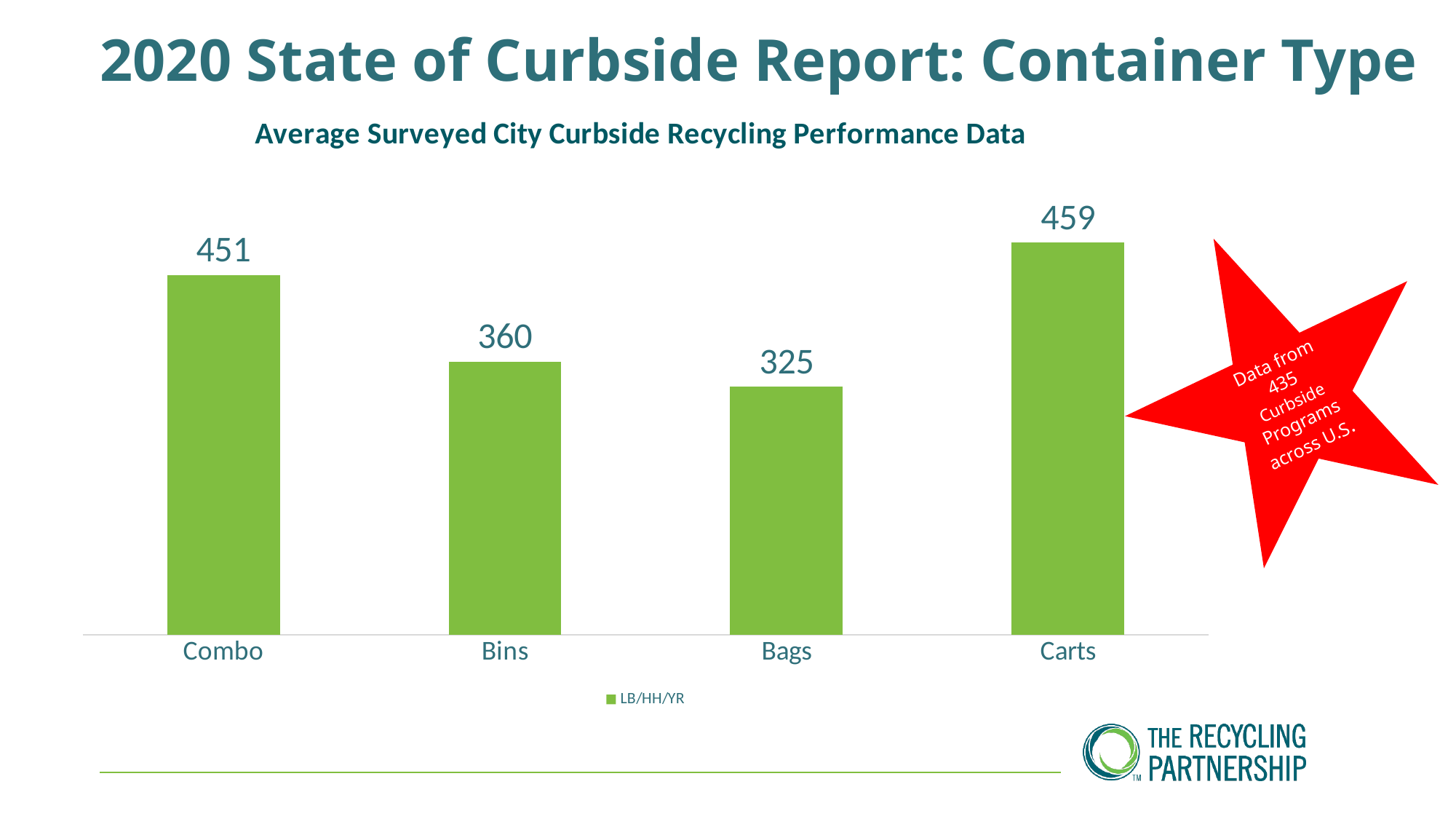
Which container type has the lowest value? Bags Which is larger, the value for Bins or the value for Bags? Bins What is the LB/HH/YR value for Bags? 325 How many container types are shown in the chart? 4 What is the LB/HH/YR value for Combo? 451 What kind of chart is shown on the slide? Bar chart What series name does the legend show? LB/HH/YR Which container type has the highest value? Carts What is the LB/HH/YR value for Carts? 459 What is the difference between the values for Combo and Bins? 91 What is the LB/HH/YR value for Bins? 360 What is the difference between the values for Carts and Bags? 134